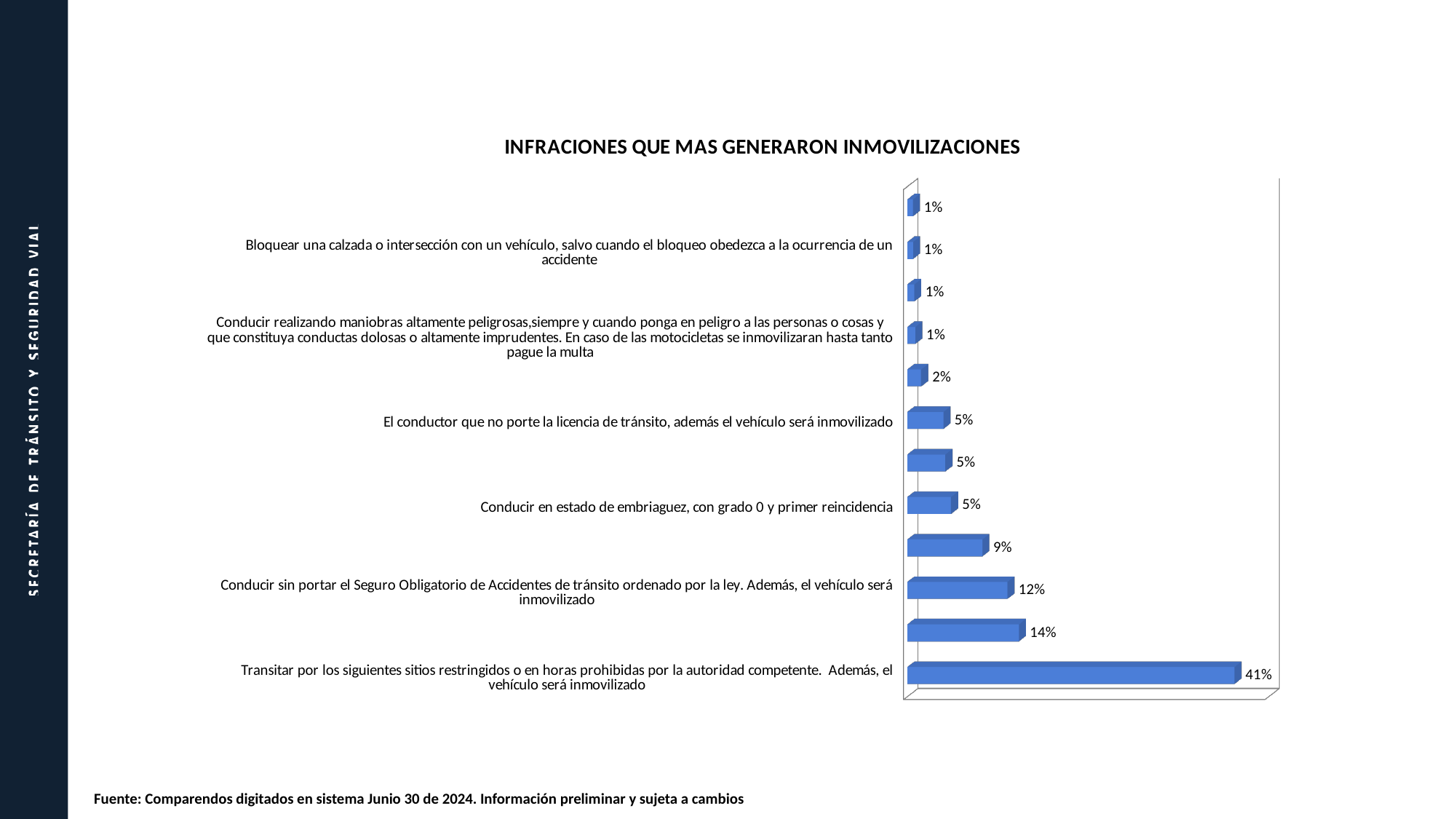
What is the value for "El conductor que no porte la licencia de tránsito, además el vehículo será inmovilizado"? 5% What is the value for "Conducir en estado de embriaguez, con grado 0 y primer reincidencia"? 5% What is the highest value shown on the chart? 41% What is the difference between the value for "Transitar por los siguientes sitios restringidos" and the value for "Conducir sin portar el Seguro Obligatorio"? 29 percentage points What kind of chart is shown on the slide? Bar chart What is the value for "Conducir sin portar el Seguro Obligatorio de Accidentes de tránsito ordenado por la ley"? 12% Which is larger: the value for "Conducir sin portar el Seguro Obligatorio" or the value for "Conducir en estado de embriaguez"? Conducir sin portar el Seguro Obligatorio What is the value for "Conducir realizando maniobras altamente peligrosas"? 1% What is the value for "Bloquear una calzada o intersección con un vehículo, salvo cuando el bloqueo obedezca a la ocurrencia de un accidente"? 1% Which category has the highest value? Transitar por los siguientes sitios restringidos o en horas prohibidas por la autoridad competente. Además, el vehículo será inmovilizado How many bars are plotted on the chart? 12 What is the value for "Transitar por los siguientes sitios restringidos o en horas prohibidas por la autoridad competente"? 41%